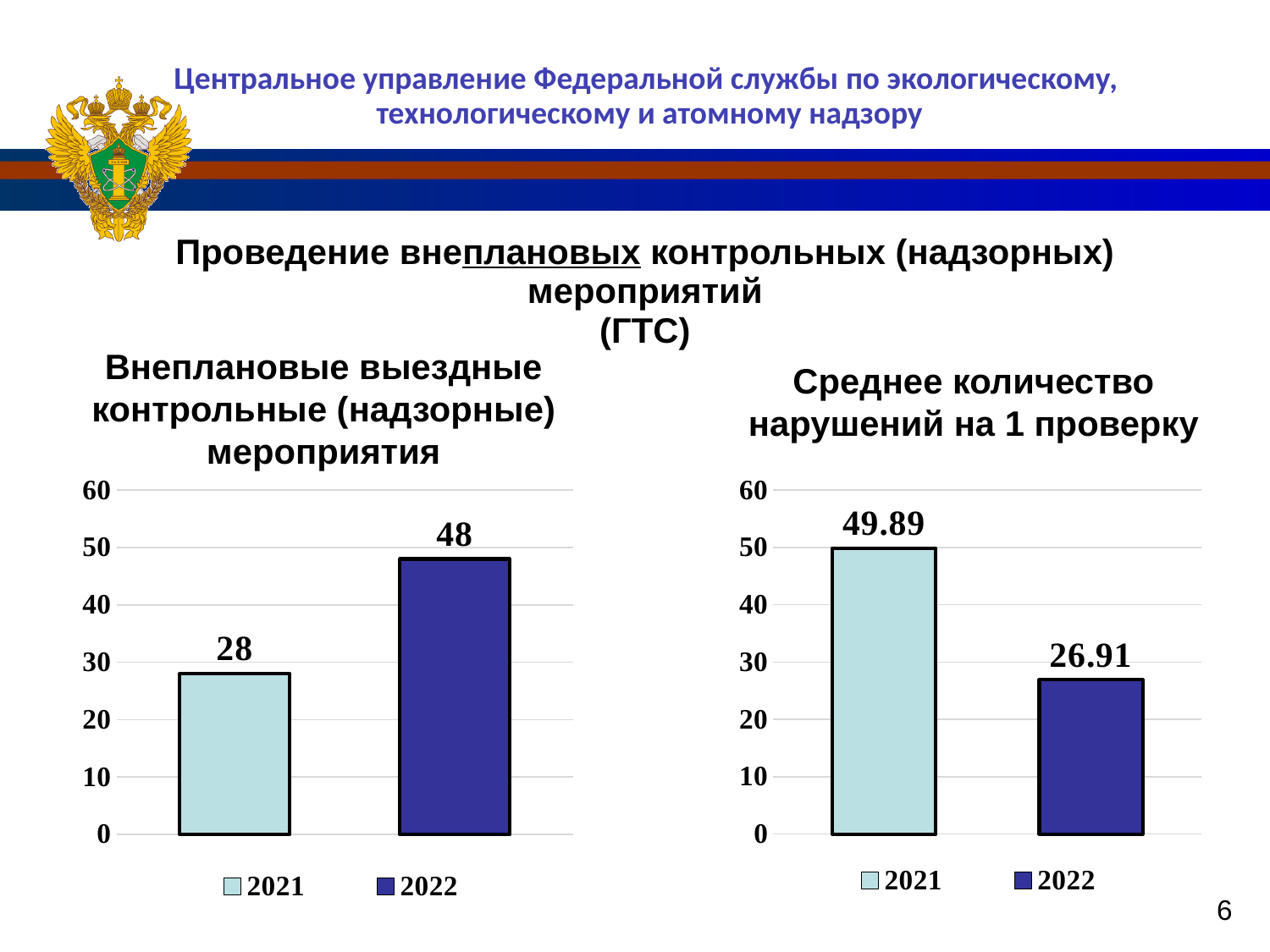
In the left chart (Внеплановые выездные контрольные (надзорные) мероприятия), what is the value for 2021? 28 In the right chart (Среднее количество нарушений на 1 проверку), which year has the lower value? 2022 In the right chart (Среднее количество нарушений на 1 проверку), do the values rise or fall from 2021 to 2022? fall What kind of chart is the right chart (Среднее количество нарушений на 1 проверку)? bar chart How many series does the legend of the left chart (Внеплановые выездные контрольные (надзорные) мероприятия) list? 2 In the right chart (Среднее количество нарушений на 1 проверку), what is the value for 2021? 49.89 In the left chart (Внеплановые выездные контрольные (надзорные) мероприятия), which year has the higher value? 2022 In the right chart (Среднее количество нарушений на 1 проверку), is the value for 2021 greater or less than 40? greater In the left chart (Внеплановые выездные контрольные (надзорные) мероприятия), what is the difference between the 2022 and 2021 values? 20 In the right chart (Среднее количество нарушений на 1 проверку), what is the difference between the 2021 and 2022 values? 22.98 In the left chart (Внеплановые выездные контрольные (надзорные) мероприятия), what is the value for 2022? 48 In the right chart (Среднее количество нарушений на 1 проверку), what is the value for 2022? 26.91